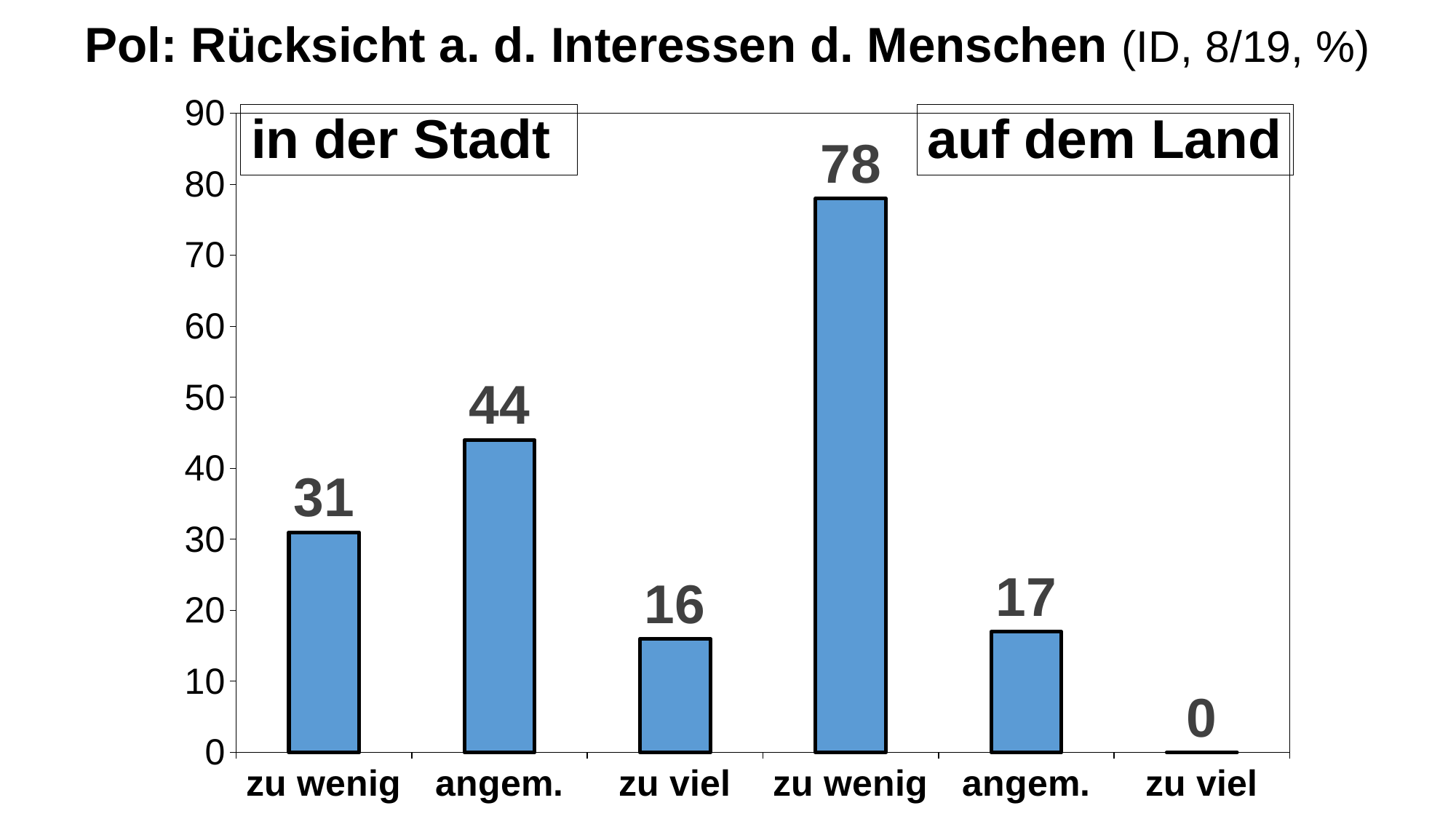
Which is larger: "angem." in the "in der Stadt" group or "zu wenig" in the "in der Stadt" group? angem. (in der Stadt) Which bar has the lowest value on the chart? zu viel (auf dem Land) What is the difference between "angem." in the "in der Stadt" group and "angem." in the "auf dem Land" group? 27 Which bar has the highest value on the chart? zu wenig (auf dem Land) Is the value for "zu viel" in the "in der Stadt" group greater or less than 20? less How many bars are plotted on the chart? 6 What is the difference between "zu wenig" in the "auf dem Land" group and "zu wenig" in the "in der Stadt" group? 47 What is the value for "zu viel" in the "auf dem Land" group? 0 What is the title of the chart? Pol: Rücksicht a. d. Interessen d. Menschen (ID, 8/19, %) What kind of chart is shown on the slide? bar chart What is the value for "zu wenig" in the "in der Stadt" group? 31 What is the value for "angem." in the "auf dem Land" group? 17